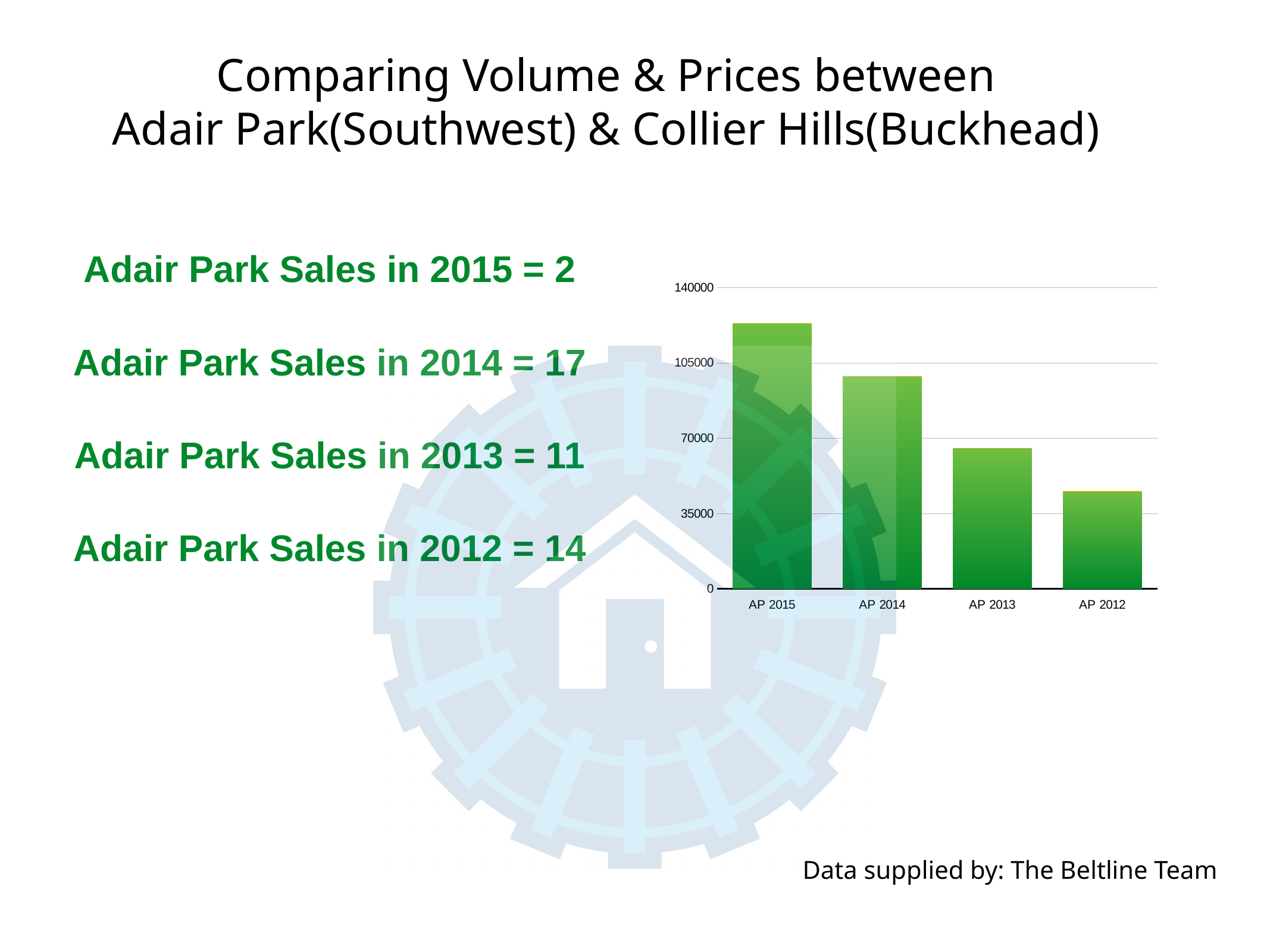
Which is larger, the value for AP 2014 or the value for AP 2013? AP 2014 What kind of chart is shown on the slide? bar chart Is the value for AP 2012 greater or less than 35000? greater How many categories are plotted on the chart? 4 Do the bar values rise or fall moving from AP 2015 to AP 2012 along the x axis? fall Is the value for AP 2014 greater or less than 105000? less What is the label of the leftmost category on the chart's x axis? AP 2015 Is the value for AP 2013 greater or less than 70000? less Which category has the lowest bar on the chart? AP 2012 Which category has the highest bar on the chart? AP 2015 What is the highest value shown on the chart's vertical axis? 140000